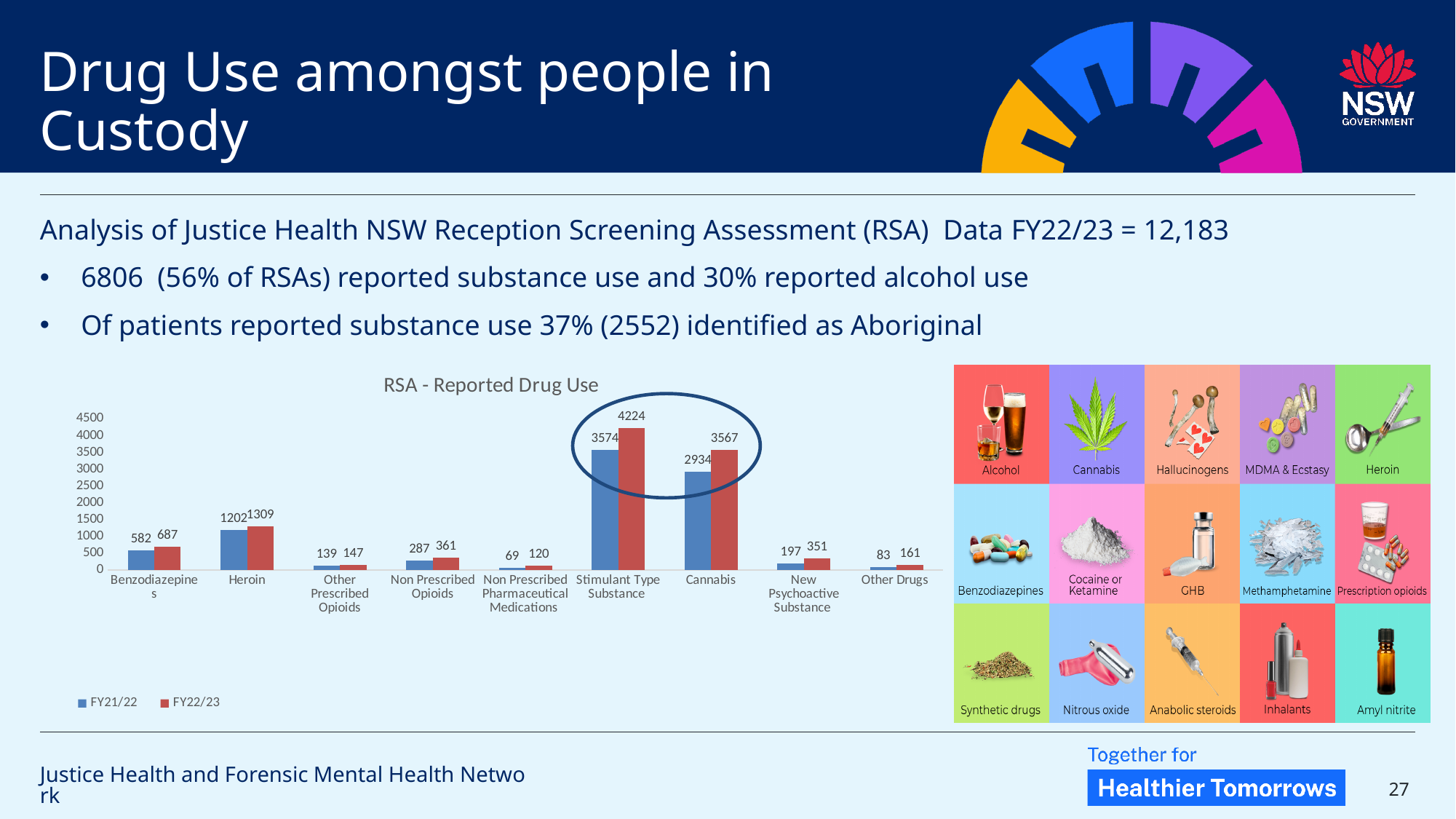
Which category has the lowest FY21/22 value? Non Prescribed Pharmaceutical Medications Which category has the highest FY22/23 value? Stimulant Type Substance What type of chart is used to show RSA - Reported Drug Use? Bar chart What is the difference between the FY22/23 and FY21/22 values for Stimulant Type Substance? 650 What is the FY22/23 value for Stimulant Type Substance? 4224 How many series does the chart legend list? 2 What is the difference between the FY22/23 and FY21/22 values for Cannabis? 633 Which is larger, the FY22/23 value for New Psychoactive Substance or the FY22/23 value for Other Drugs? New Psychoactive Substance What is the title of the chart? RSA - Reported Drug Use How many drug categories are shown on the x axis of the chart? 9 What is the FY22/23 value for Heroin? 1309 What is the FY21/22 value for Cannabis? 2934